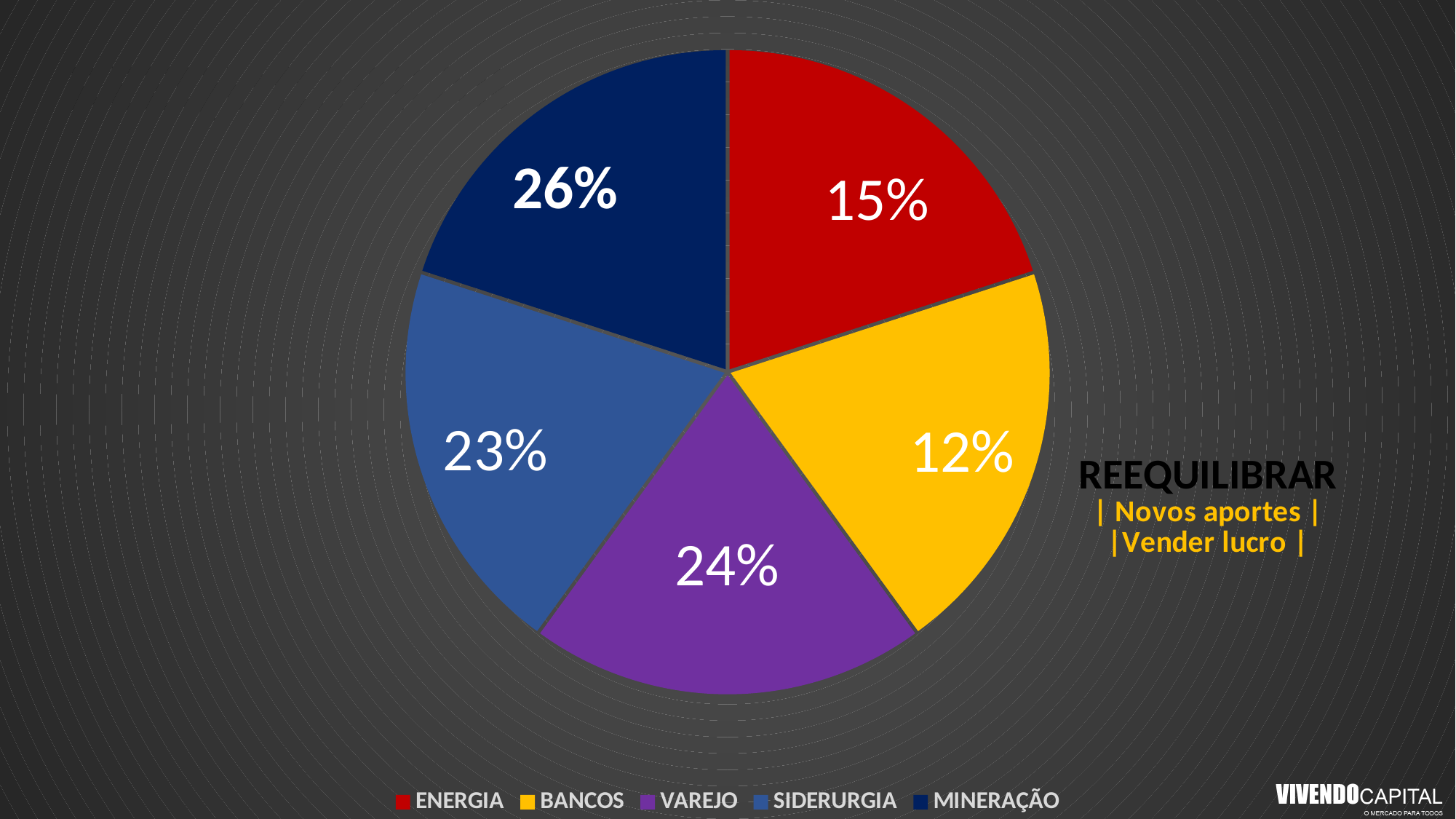
What is the value for VAREJO? 24% What is the value for SIDERURGIA? 23% What colour is the VAREJO slice? purple Which category has the largest share of the pie? MINERAÇÃO What is the value for ENERGIA? 15% How many categories does the pie chart have? 5 What is the value for BANCOS? 12% Which category has the smallest share of the pie? BANCOS What is the difference between the values for MINERAÇÃO and BANCOS? 14% What kind of chart is shown on the slide? pie chart Which is larger, the value for ENERGIA or the value for BANCOS? ENERGIA What is the value for MINERAÇÃO? 26%